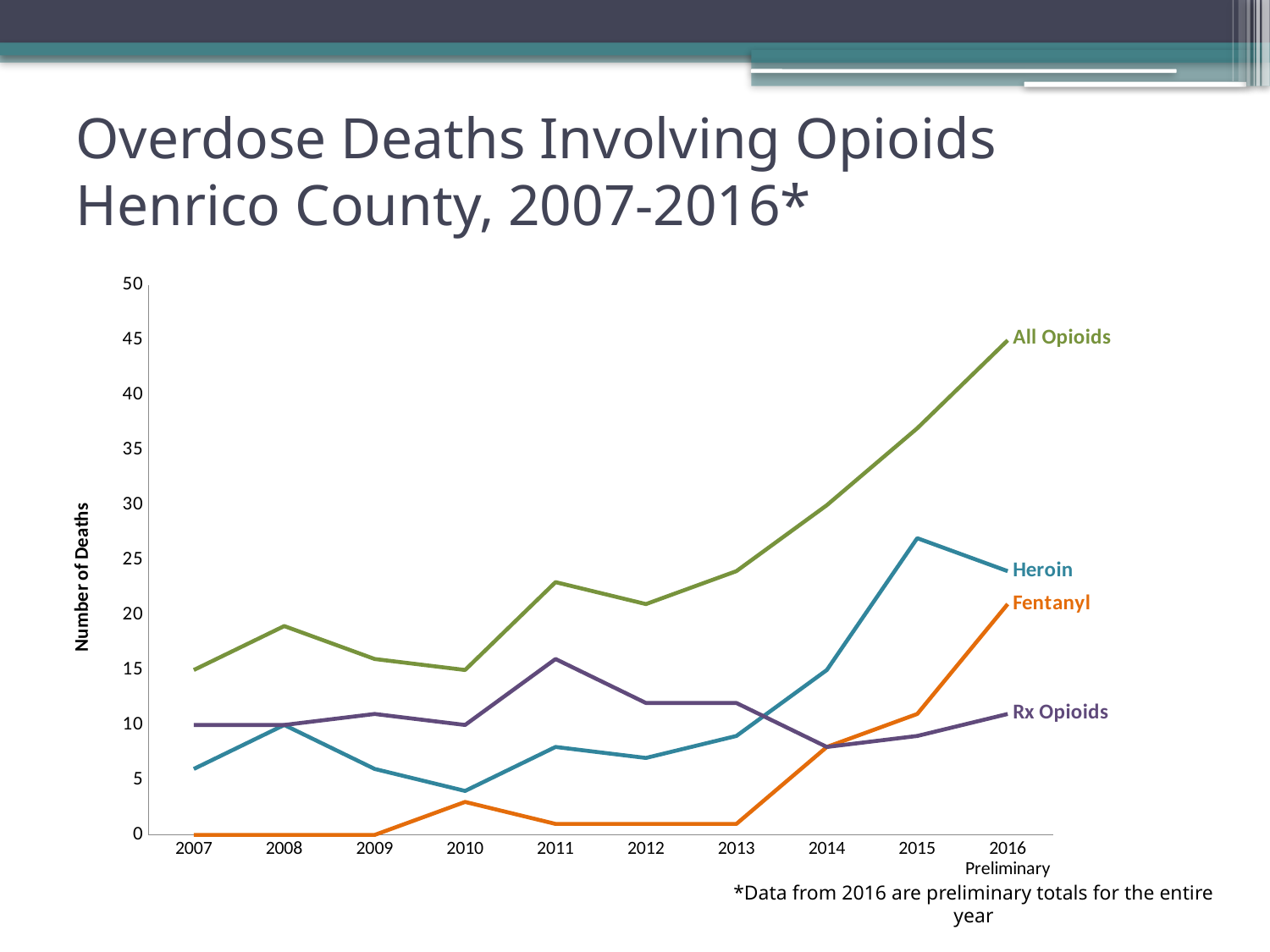
Is the value for Fentanyl in 2016 greater or less than 15? greater What kind of chart is shown on the slide? line chart What is the value for All Opioids in 2007? 15 Is the value for Heroin in 2015 greater or less than 25? greater What is the value for Fentanyl in 2007? 0 Is the value for All Opioids in 2016 greater or less than 40? greater How many series are labelled on the chart? 4 What is the value for Rx Opioids in 2007? 10 Which series has the highest value in 2016? All Opioids In 2015, which is larger, Heroin or Fentanyl? Heroin Does the All Opioids line rise or fall overall from 2007 to 2016? rise How many years are plotted along the x axis? 10